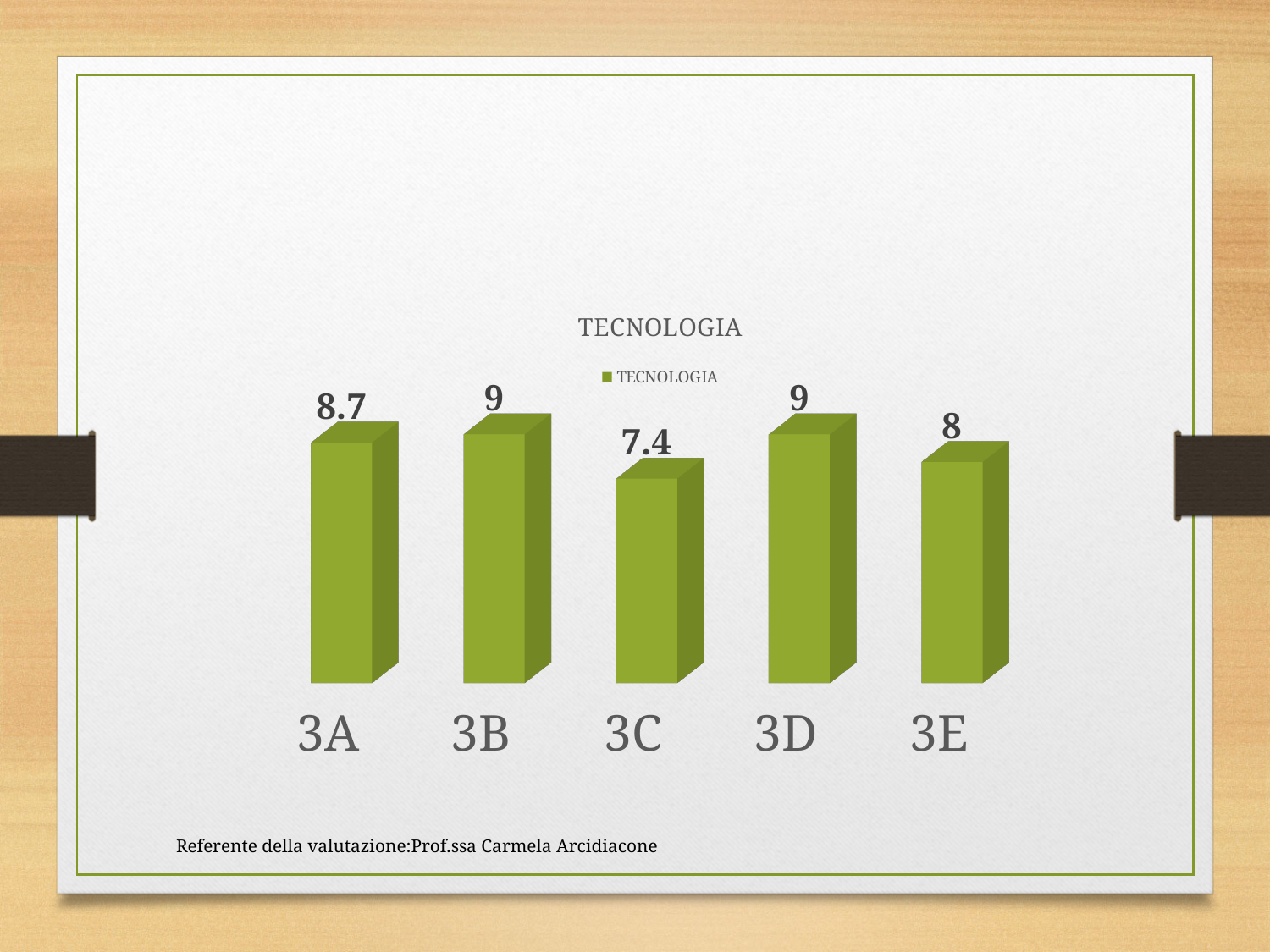
What is the value for 3A? 8.7 What is the title of the chart? TECNOLOGIA What is the value for 3E? 8 How many categories are shown on the x axis? 5 Which is larger, the value for 3A or the value for 3E? 3A What is the difference between the values for 3D and 3E? 1 Which category has the lowest value? 3C What is the value for 3B? 9 What is the value for 3C? 7.4 How many series does the legend list? 1 What kind of chart is shown? bar chart What is the difference between the values for 3A and 3C? 1.3